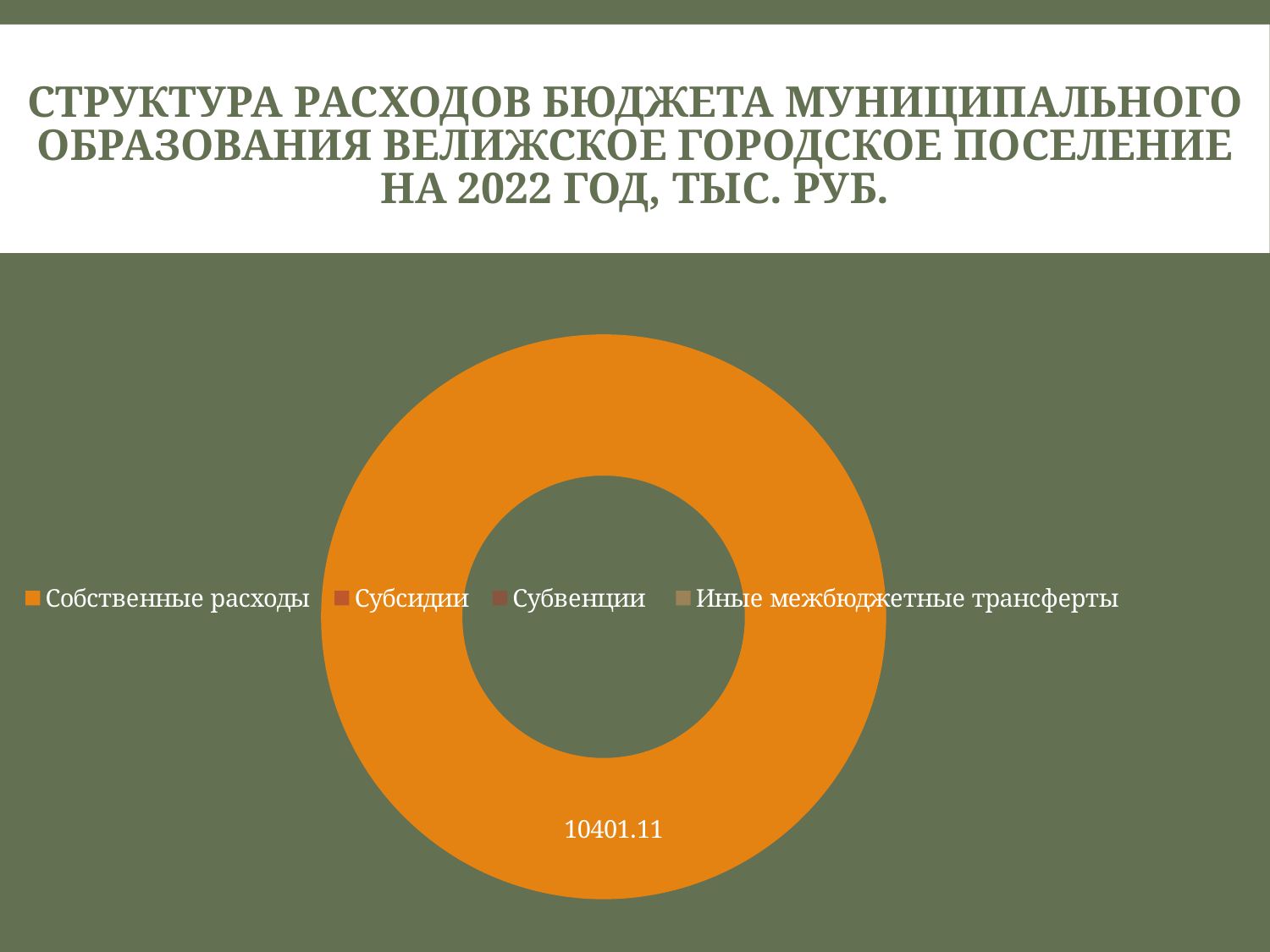
Which legend entry is listed last? Иные межбюджетные трансферты Which category occupies the largest share of the chart? Собственные расходы Is the value for Собственные расходы greater or less than 10000? greater What kind of chart is shown on the slide? Doughnut (pie) chart What is the value for Собственные расходы? 10401.11 What colour is the slice for Собственные расходы? Orange What value is shown on the data label of the chart? 10401.11 How many entries does the legend list? 4 What unit of measurement is stated in the chart title? тыс. руб.